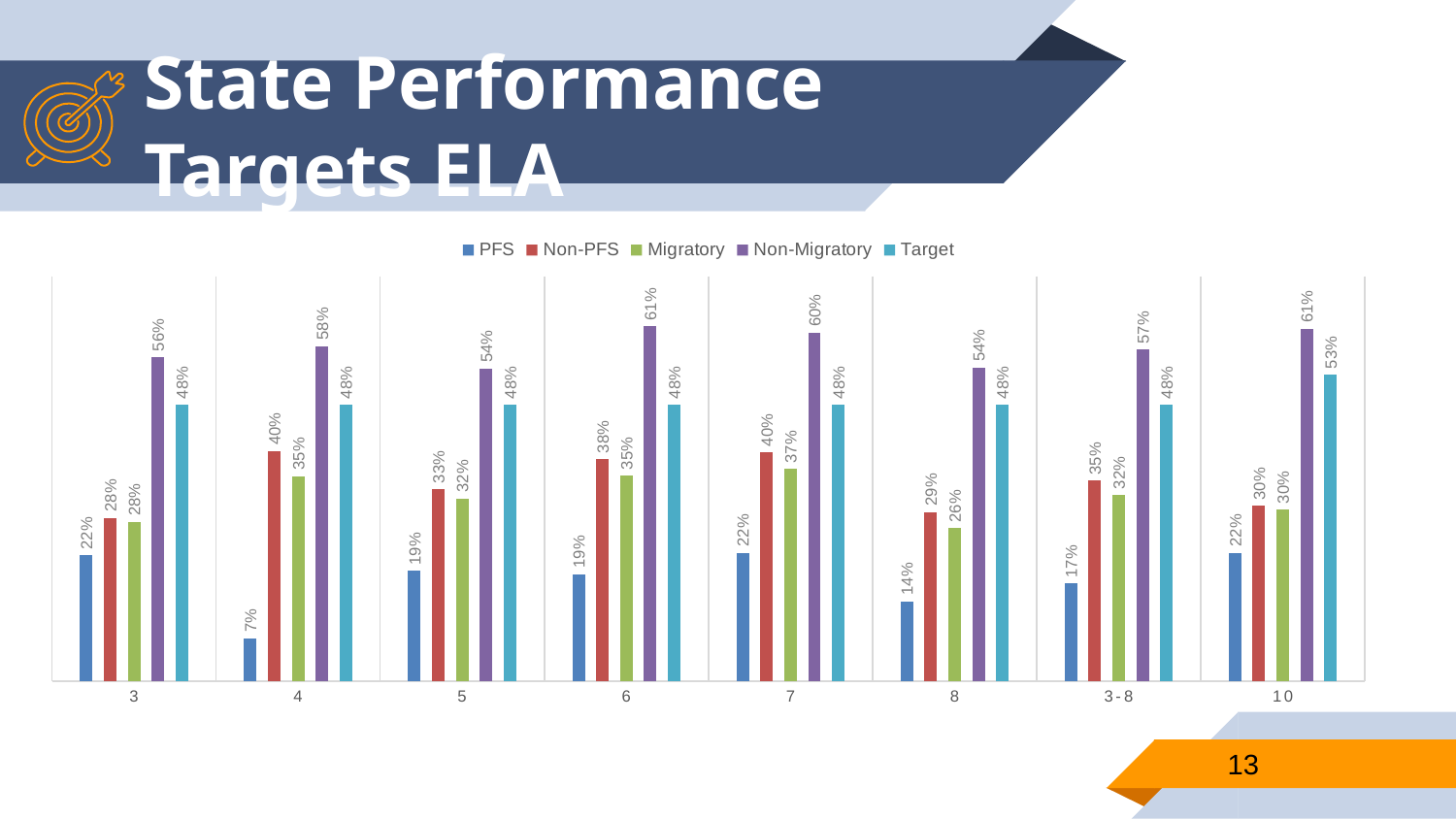
How many series does the legend list? 5 What kind of chart is shown on the slide? bar chart Which series is shown in purple in the legend? Non-Migratory What is the PFS value for category 4? 7% Which category has the lowest PFS value? 4 What is the Non-Migratory value for category 6? 61% Which category has the highest Non-PFS value? 4 and 7 (both 40%) What is the difference between the Non-Migratory and Target values for category 7? 12% What is the Migratory value for category 3-8? 32% What is the Target value for category 10? 53% For category 8, which is larger: the Non-PFS value or the Migratory value? Non-PFS How many categories are shown along the x axis? 8